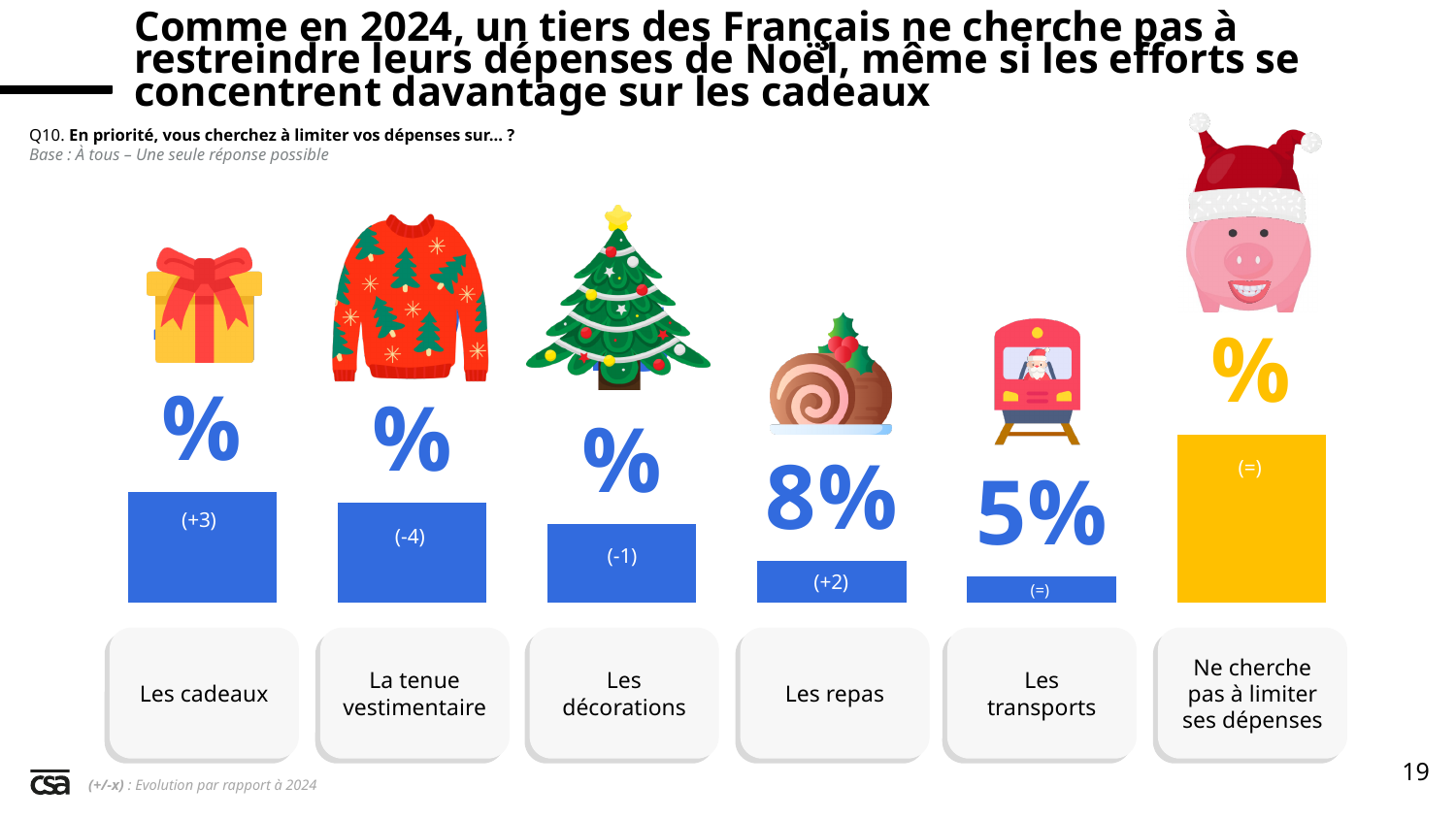
What kind of chart is shown on the slide? Bar chart What is the difference between the values for Les repas and Les transports? 3 percentage points What evolution compared to 2024 is shown for La tenue vestimentaire? (-4) How many categories are shown in the chart? 6 Which is larger, the value for Les repas or the value for Les transports? Les repas Which is larger, the bar for Les décorations or the bar for Les repas? Les décorations What evolution compared to 2024 is shown for Les cadeaux? (+3) Which category has the tallest bar? Ne cherche pas à limiter ses dépenses Which category has the shortest bar? Les transports What is the value for Les transports? 5% What is the value for Les repas? 8% Which bar is coloured yellow rather than blue? Ne cherche pas à limiter ses dépenses